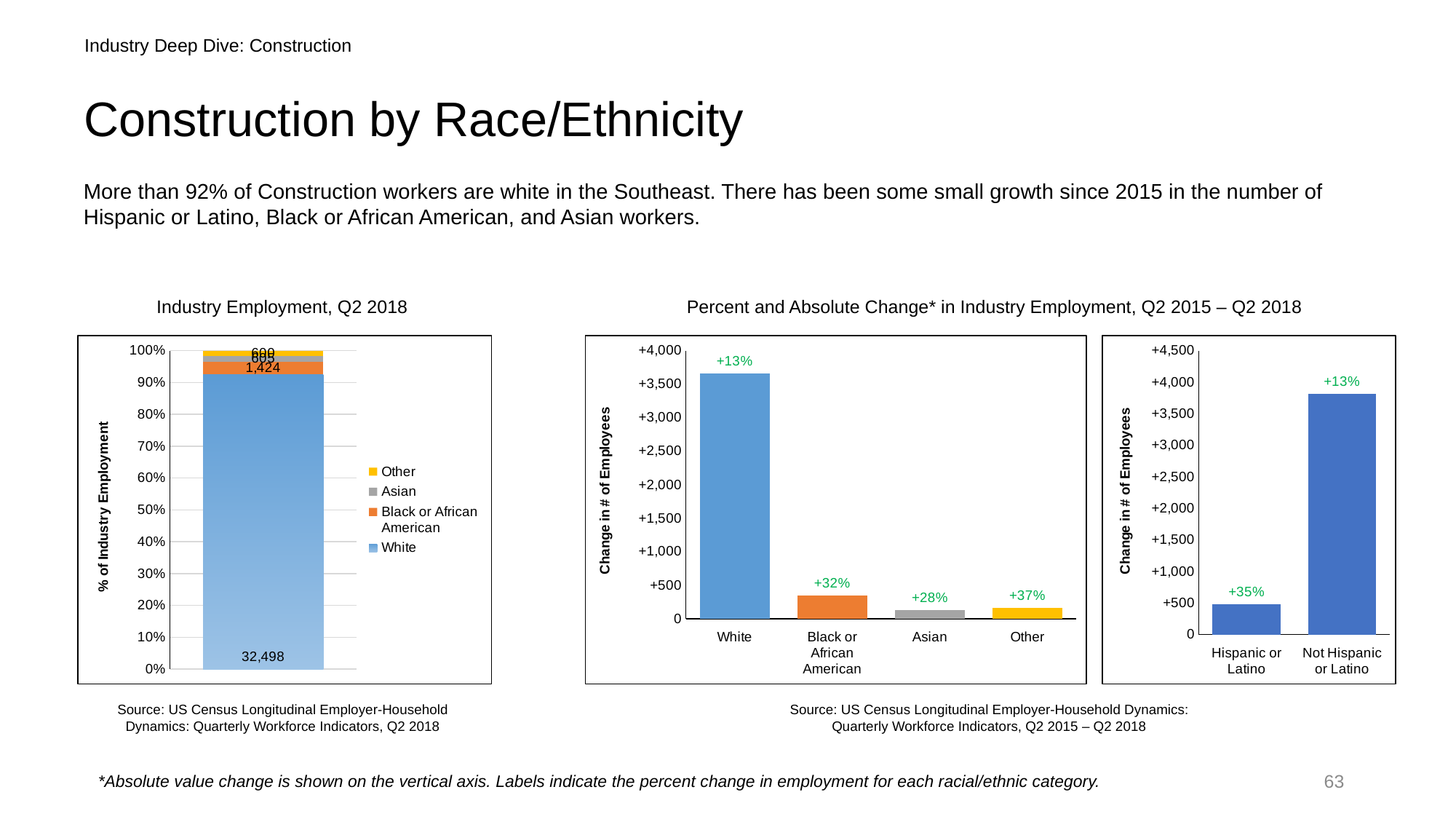
How many categories are shown on the x axis of the middle chart (Percent and Absolute Change in Industry Employment by race)? 4 In the Industry Employment, Q2 2018 chart, what value is labelled on the White segment? 32,498 In the middle chart (Percent and Absolute Change in Industry Employment by race), which category has the largest absolute change in number of employees? White In the rightmost chart (change in employment by Hispanic or Latino status), what percent change is labelled for Hispanic or Latino? +35% How many series does the legend of the Industry Employment, Q2 2018 chart list? 4 In the middle chart (Percent and Absolute Change in Industry Employment by race), which category has the highest percent change label? Other In the Industry Employment, Q2 2018 chart, what value is labelled on the Black or African American segment? 1,424 In the middle chart (Percent and Absolute Change in Industry Employment by race), what percent change is labelled for Other? +37% In the middle chart (Percent and Absolute Change in Industry Employment by race), what percent change is labelled for Black or African American? +32% In the middle chart (Percent and Absolute Change in Industry Employment by race), is the change in number of employees for White greater or less than +3,000? greater In the rightmost chart (change in employment by Hispanic or Latino status), is the change in number of employees for Not Hispanic or Latino greater or less than +3,500? greater What kind of chart is the Industry Employment, Q2 2018 chart? Stacked bar chart